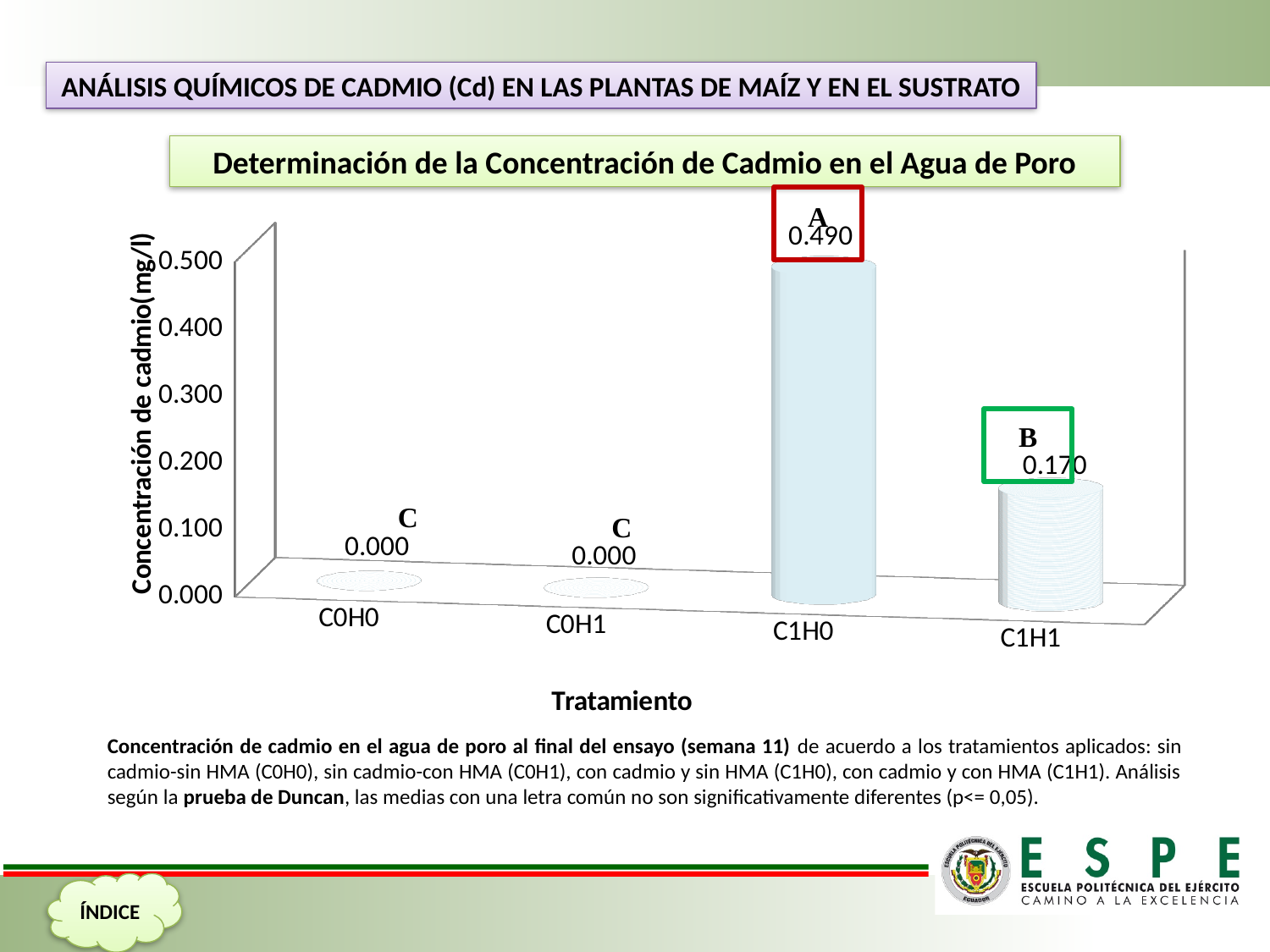
What is the cadmium concentration value for treatment C1H0? 0.490 What is the label of the y axis? Concentración de cadmio(mg/l) What is the difference between the values for C1H0 and C1H1? 0.320 What kind of chart is shown on the slide? bar chart What is the cadmium concentration value for treatment C0H0? 0.000 Is the value for C1H0 greater or less than 0.400? greater Is the value for C1H1 greater or less than 0.200? less What is the title of the chart? Determinación de la Concentración de Cadmio en el Agua de Poro What is the cadmium concentration value for treatment C1H1? 0.170 Which treatment has the highest cadmium concentration? C1H0 How many treatments are shown on the x axis? 4 Which is larger, the value for C1H1 or the value for C0H1? C1H1